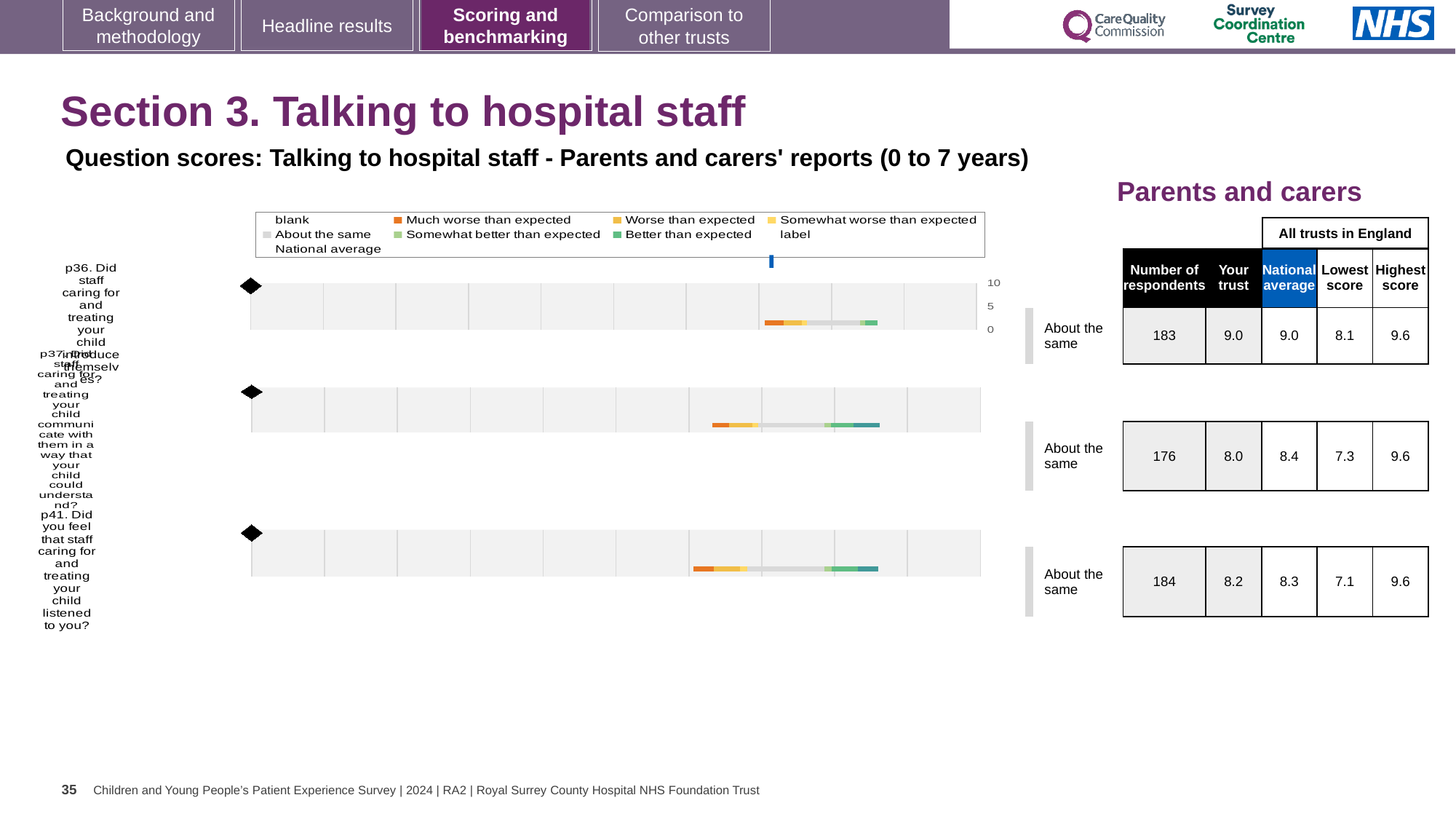
What kind of chart is shown on the slide? bar chart In the table beside the chart, what is the 'Your trust' score for p36 (Did staff caring for and treating your child introduce themselves)? 9.0 How many survey questions (rows) are plotted in the chart? 3 In the table beside the chart, how many respondents are listed for p37? 176 Is the 'Your trust' score higher for p36 or for p41? p36 In the chart legend, what colour represents 'Much worse than expected'? orange What is the difference between the national average and the 'Your trust' score for p37? 0.4 In the table beside the chart, what is the lowest score for p37? 7.3 Which question has the fewest respondents in the table beside the chart? p37 In the table beside the chart, what is the national average for p41 (Did you feel that staff caring for and treating your child listened to you)? 8.3 What are the tick values shown on the chart's score axis? 0, 5, 10 Which question has the highest 'Your trust' score in the table beside the chart? p36